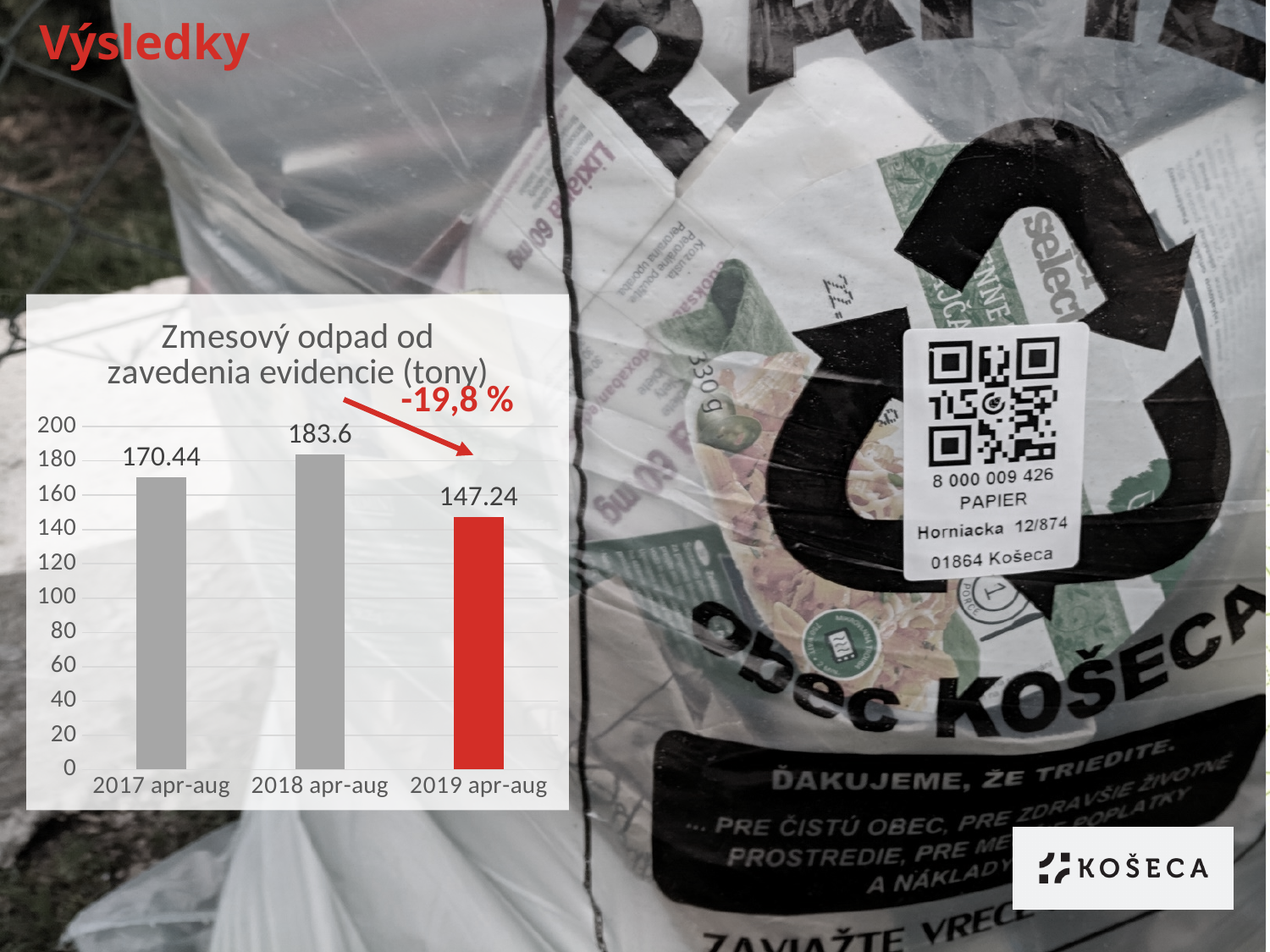
What kind of chart is shown on the slide? bar chart What is the title of the chart? Zmesový odpad od zavedenia evidencie (tony) Is the value for 2019 apr-aug greater or less than 160? less Which period has the highest value? 2018 apr-aug What is the value for 2018 apr-aug? 183.6 What is the value for 2017 apr-aug? 170.44 What is the difference between the values for 2018 apr-aug and 2017 apr-aug? 13.16 How many periods are shown on the chart? 3 What is the value for 2019 apr-aug? 147.24 Which period has the lowest value? 2019 apr-aug Which is larger, the value for 2017 apr-aug or 2019 apr-aug? 2017 apr-aug What is the difference between the values for 2018 apr-aug and 2019 apr-aug? 36.36